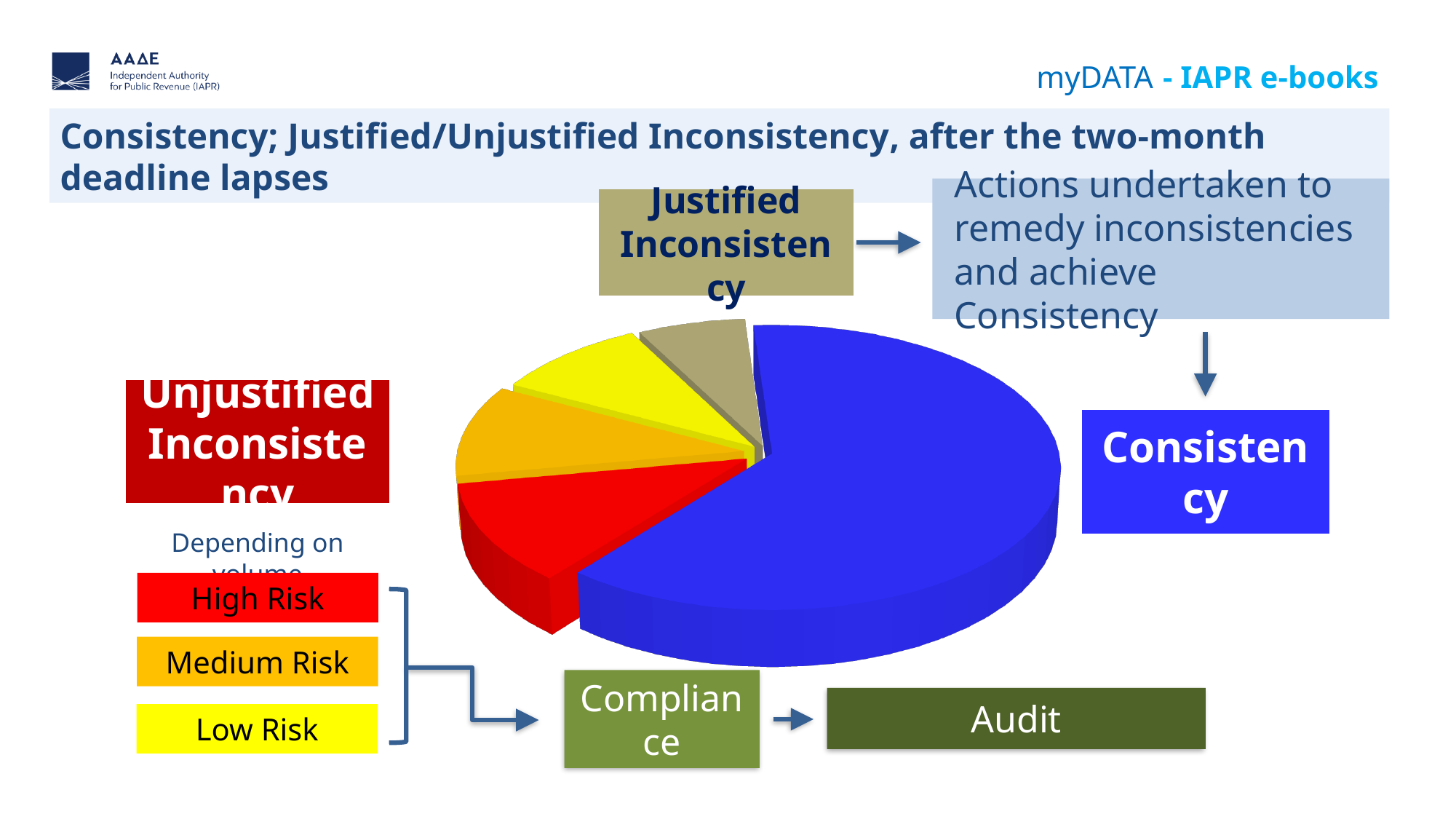
Which category has the smallest slice of the pie chart? Justified Inconsistency What kind of chart is shown on the slide? pie chart How many slices does the pie chart have? 5 What colour is the High Risk slice of the pie chart? red Which slice is larger: High Risk or Low Risk? High Risk Which category has the largest slice of the pie chart? Consistency What colour is the Consistency slice of the pie chart? blue Which slice is larger: Consistency or High Risk? Consistency Which slice is larger: High Risk or Justified Inconsistency? High Risk Does the Consistency slice take up more or less than half of the pie chart? more